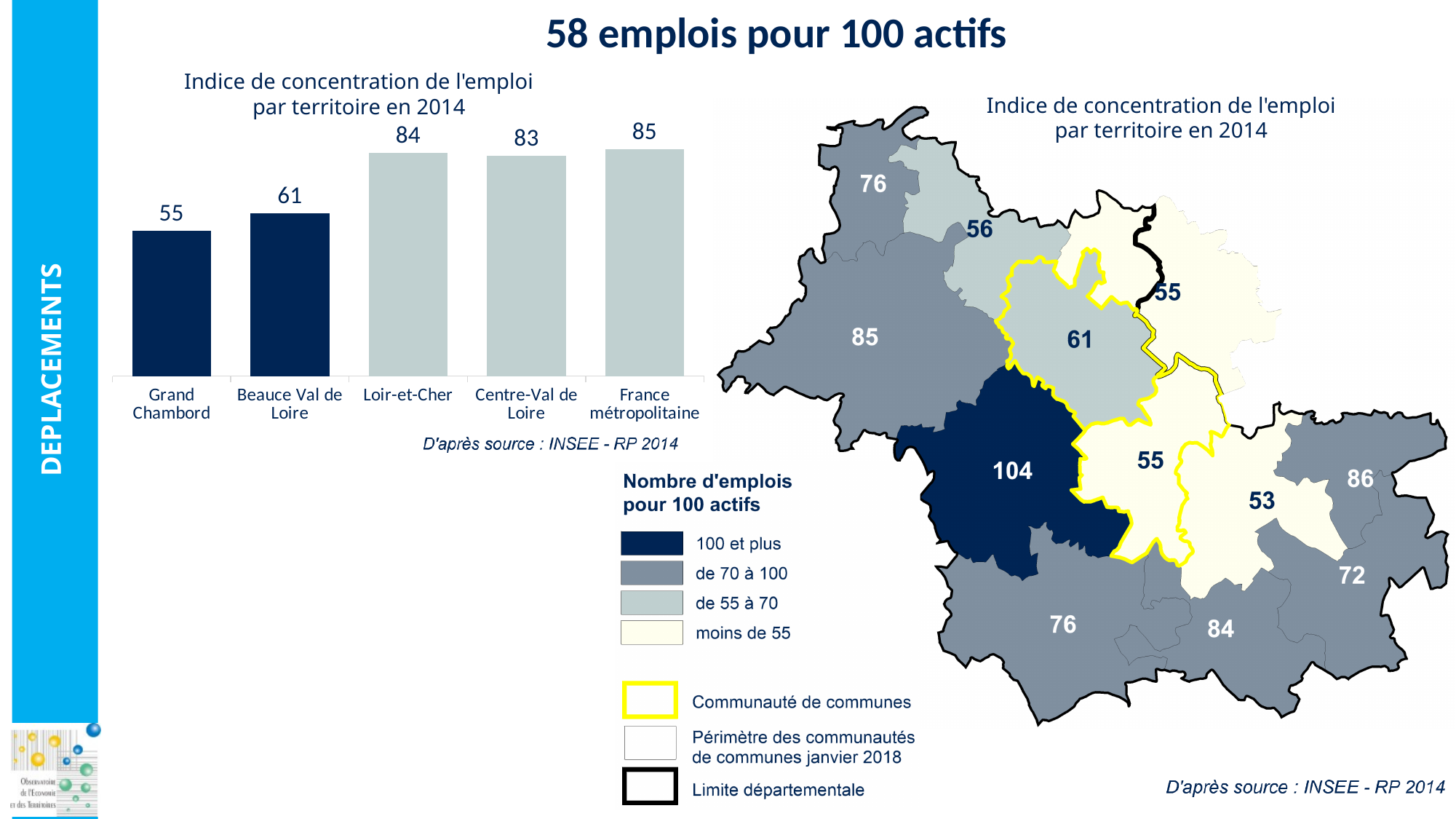
What is the title of the bar chart? Indice de concentration de l'emploi par territoire en 2014 What kind of chart is the chart on the left of the slide? Bar chart In the bar chart, which territory has the lowest value? Grand Chambord In the bar chart, what is the difference between the values for Beauce Val de Loire and Grand Chambord? 6 In the bar chart, what is the value for Beauce Val de Loire? 61 In the bar chart, which is larger: the value for Loir-et-Cher or the value for Centre-Val de Loire? Loir-et-Cher In the bar chart, what is the value for Centre-Val de Loire? 83 In the bar chart, which territory has the highest value? France métropolitaine How many territories are shown in the bar chart? 5 In the bar chart, what is the value for Loir-et-Cher? 84 In the bar chart, what is the difference between the values for France métropolitaine and Grand Chambord? 30 In the bar chart, what is the value for Grand Chambord? 55